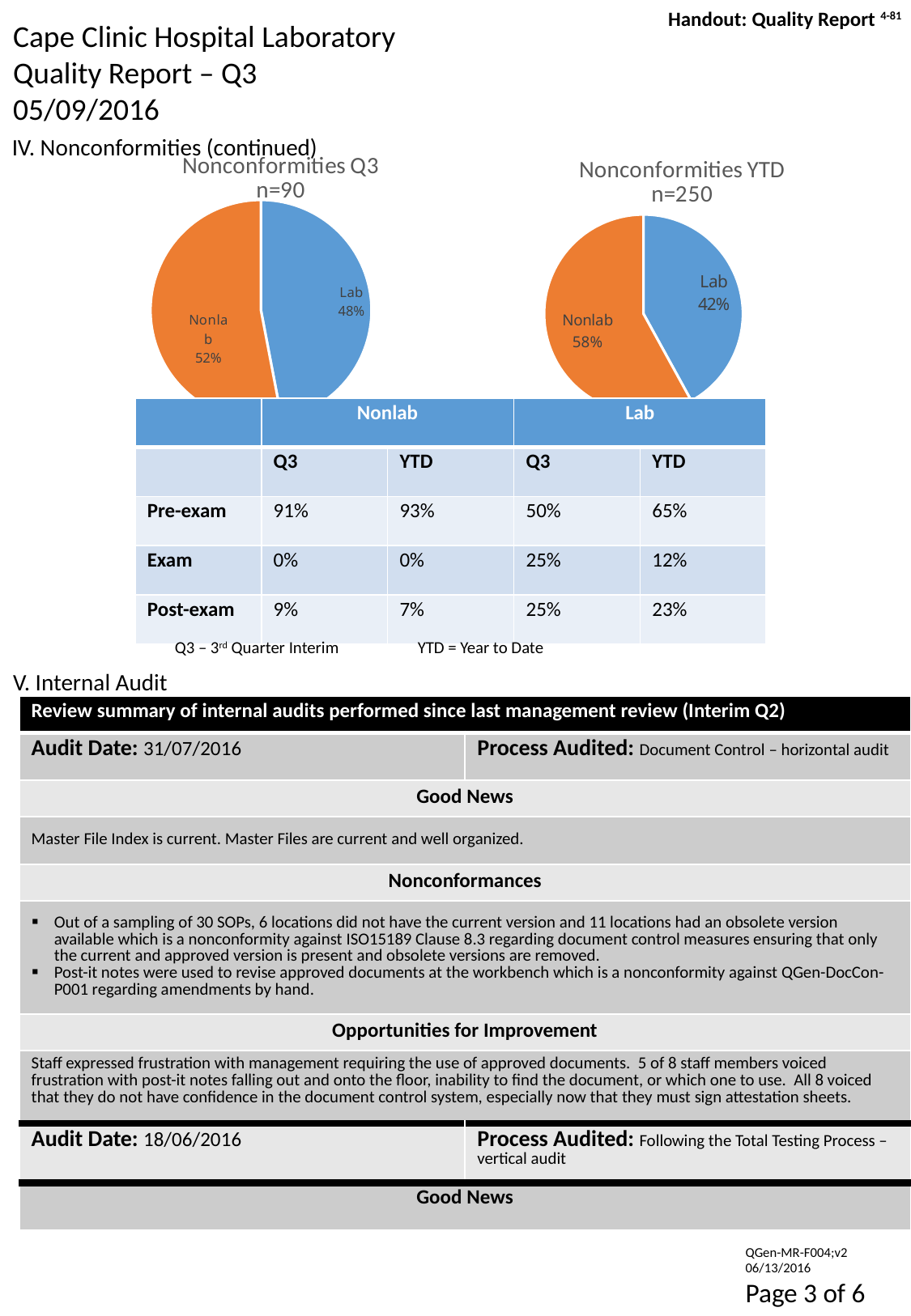
In the Nonconformities YTD chart, what share of nonconformities is Lab? 42% How many slices does the Nonconformities YTD pie chart have? 2 In the Nonconformities YTD chart, which slice is larger, Lab or Nonlab? Nonlab In the Nonconformities YTD chart, what share of nonconformities is Nonlab? 58% What type of chart is the Nonconformities Q3 chart? Pie chart In the Nonconformities Q3 chart, what share of nonconformities is Lab? 48% What is the sample size (n) shown in the title of the Nonconformities YTD chart? n=250 In the Nonconformities YTD chart, which category has the smallest share? Lab In the Nonconformities Q3 chart, what is the difference between the Nonlab and Lab shares? 4% In the Nonconformities Q3 chart, which category has the largest share? Nonlab In the Nonconformities Q3 chart, what share of nonconformities is Nonlab? 52% In the Nonconformities YTD chart, what is the difference between the Nonlab and Lab shares? 16%